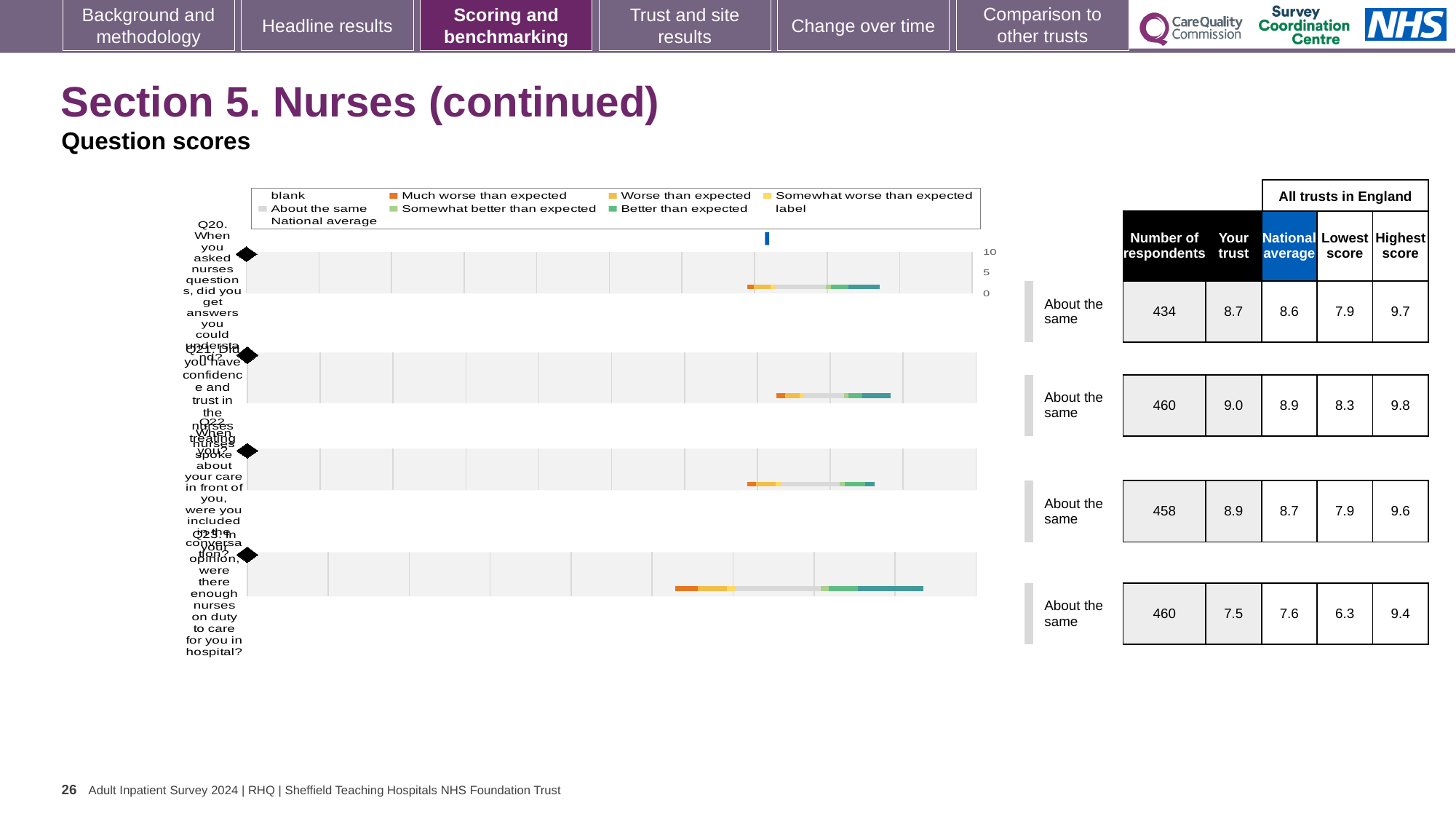
What colour does the legend use for 'Much worse than expected'? orange Which question has the highest 'Your trust' score in the table beside the chart? Q21 How many questions (Q20 to Q23) are plotted as bars in the chart? 4 How many respondents are listed for Q21 in the table beside the chart? 460 For Q21, what is the difference between the 'Your trust' score and the national average? 0.1 Which question has the lowest 'Your trust' score in the table beside the chart? Q23 What kind of chart is used to show the question scores on this slide? bar chart What benchmark category is shown next to the bar for Q20? About the same What is the highest score across all trusts in England for Q23? 9.4 For Q22, which is larger: the 'Your trust' score or the national average? Your trust According to the table beside the chart, what is the 'Your trust' score for Q20? 8.7 According to the table beside the chart, what is the national average score for Q23? 7.6